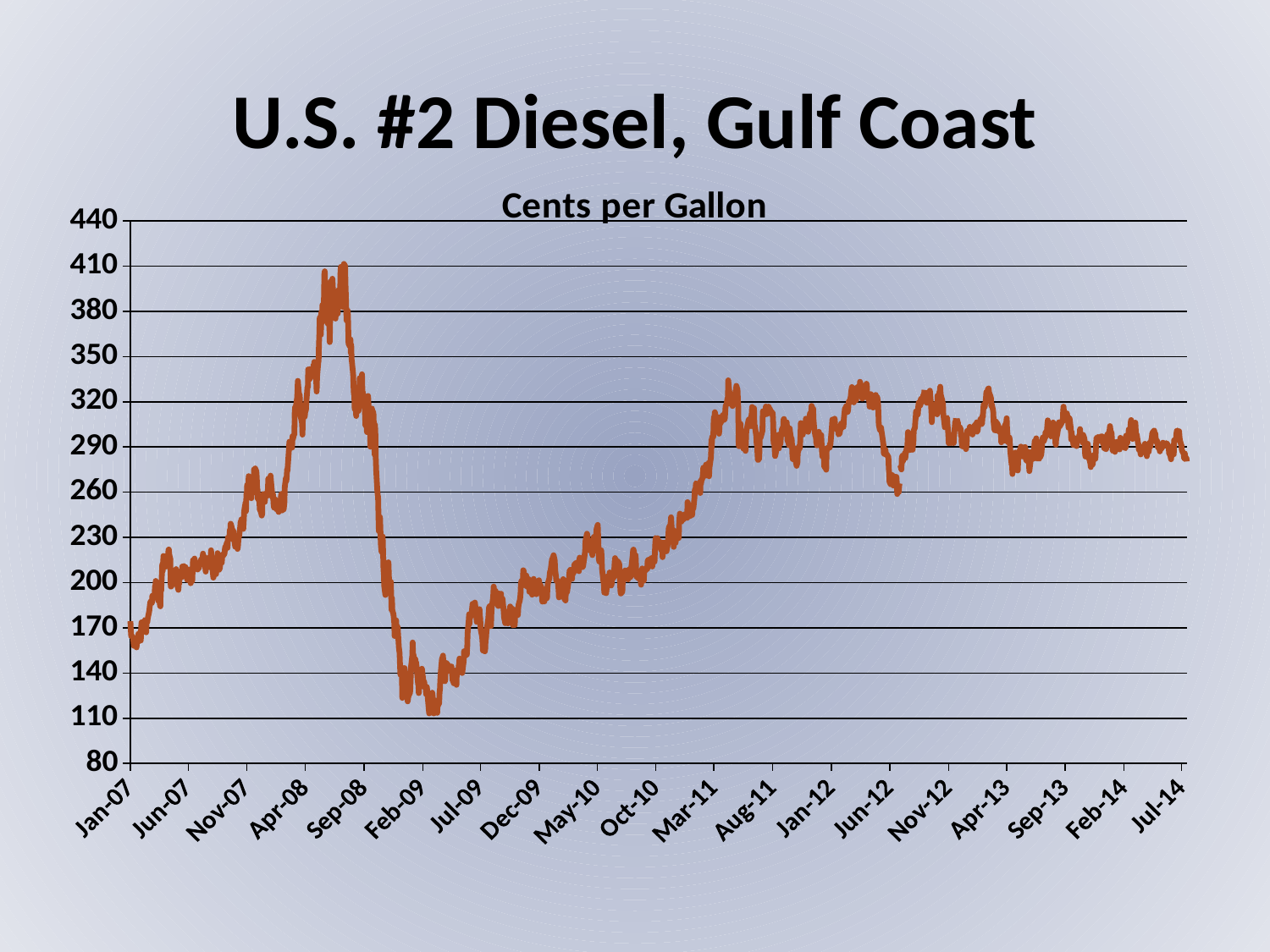
Is the lowest value reached around Feb-09 greater or less than 140? less In what units are the values on the chart expressed? Cents per Gallon Does the line rise or fall between Sep-08 and Feb-09? fall Is the value at Jul-14 greater or less than 260? greater Does the line rise or fall between Jan-07 and Sep-08? rise Is the value at Jan-07 greater or less than 200? less Near which labelled month does the line reach its lowest value? Feb-09 How many data series are plotted on the chart? 1 What is the title of the chart? Cents per Gallon How many month labels are shown along the x axis? 19 What kind of chart is shown on the slide? Line chart